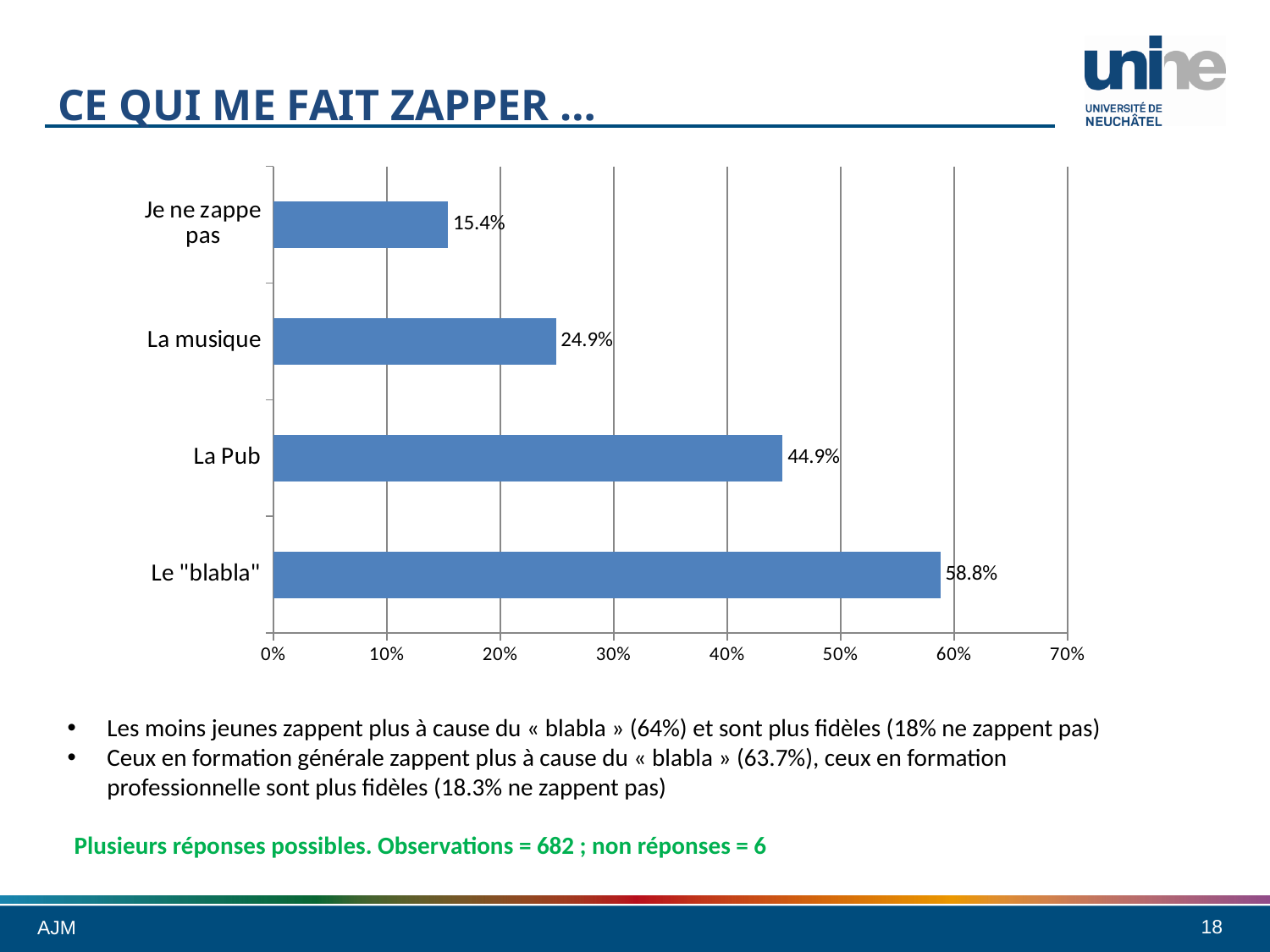
What is the value for Le "blabla"? 58.8% What is the value for La Pub? 44.9% Which category has the lowest value? Je ne zappe pas What is the value for La musique? 24.9% What is the difference between the values for Le "blabla" and La Pub? 13.9% How many categories are shown in the chart? 4 What kind of chart is shown on the slide? bar chart Is the value for La Pub greater or less than 40%? greater What is the value for Je ne zappe pas? 15.4% Which category has the highest value? Le "blabla" What is the maximum value shown on the horizontal axis? 70% Which is larger, the value for La musique or the value for Je ne zappe pas? La musique